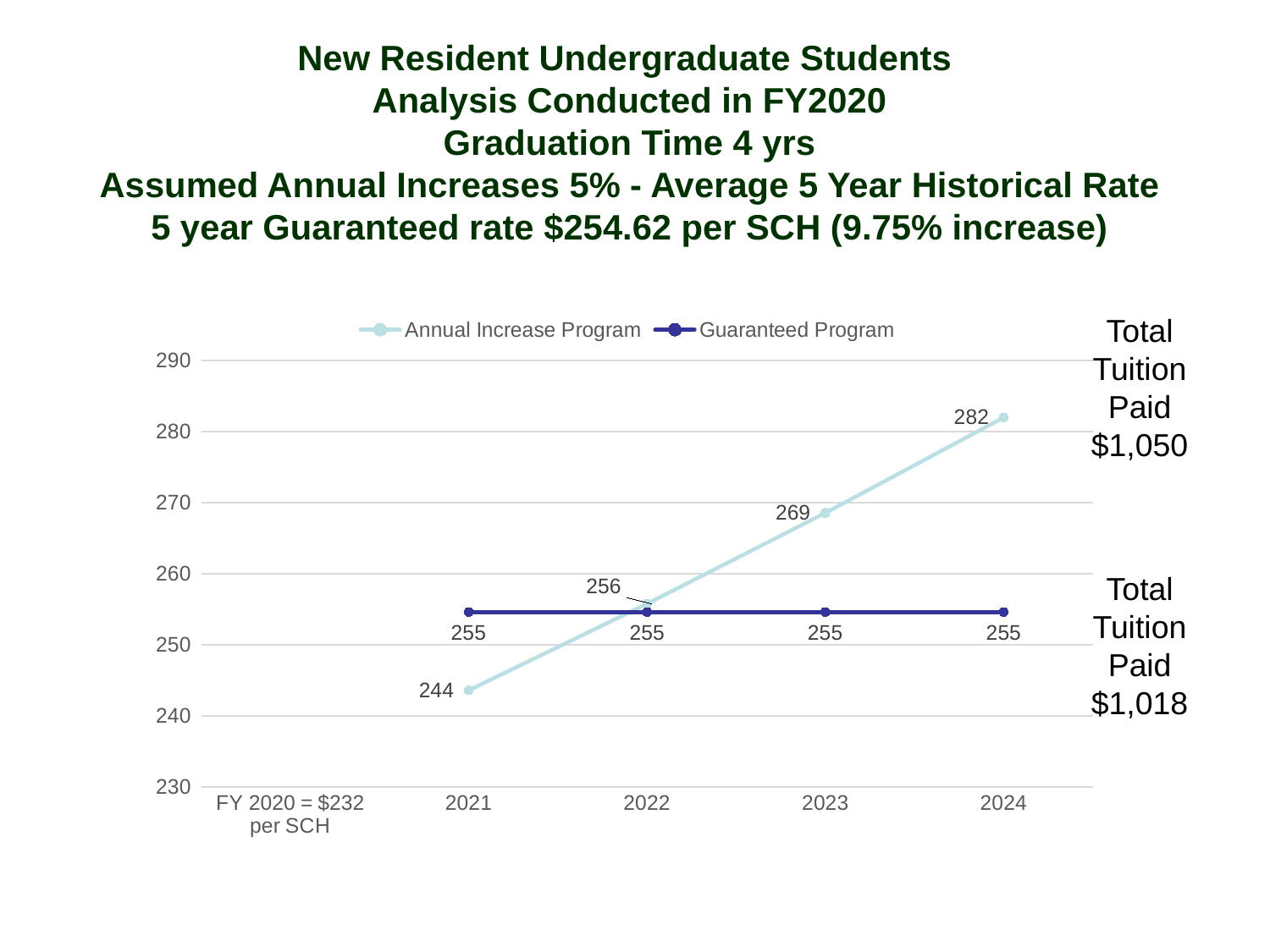
In which year is the Annual Increase Program value highest? 2024 What is the value for the Annual Increase Program in 2022? 256 What kind of chart is shown on the slide? Line chart Which series has the larger value in 2021, Annual Increase Program or Guaranteed Program? Guaranteed Program What is the difference between the Annual Increase Program and the Guaranteed Program values in 2024? 27 Do the Annual Increase Program values rise or fall from 2021 to 2024? Rise What is the value for the Annual Increase Program in 2024? 282 What is the value for the Annual Increase Program in 2021? 244 Is the Annual Increase Program value in 2023 greater or less than 260? greater How many series does the legend list? 2 What is the value for the Guaranteed Program in 2023? 255 In which year is the Annual Increase Program value lowest? 2021